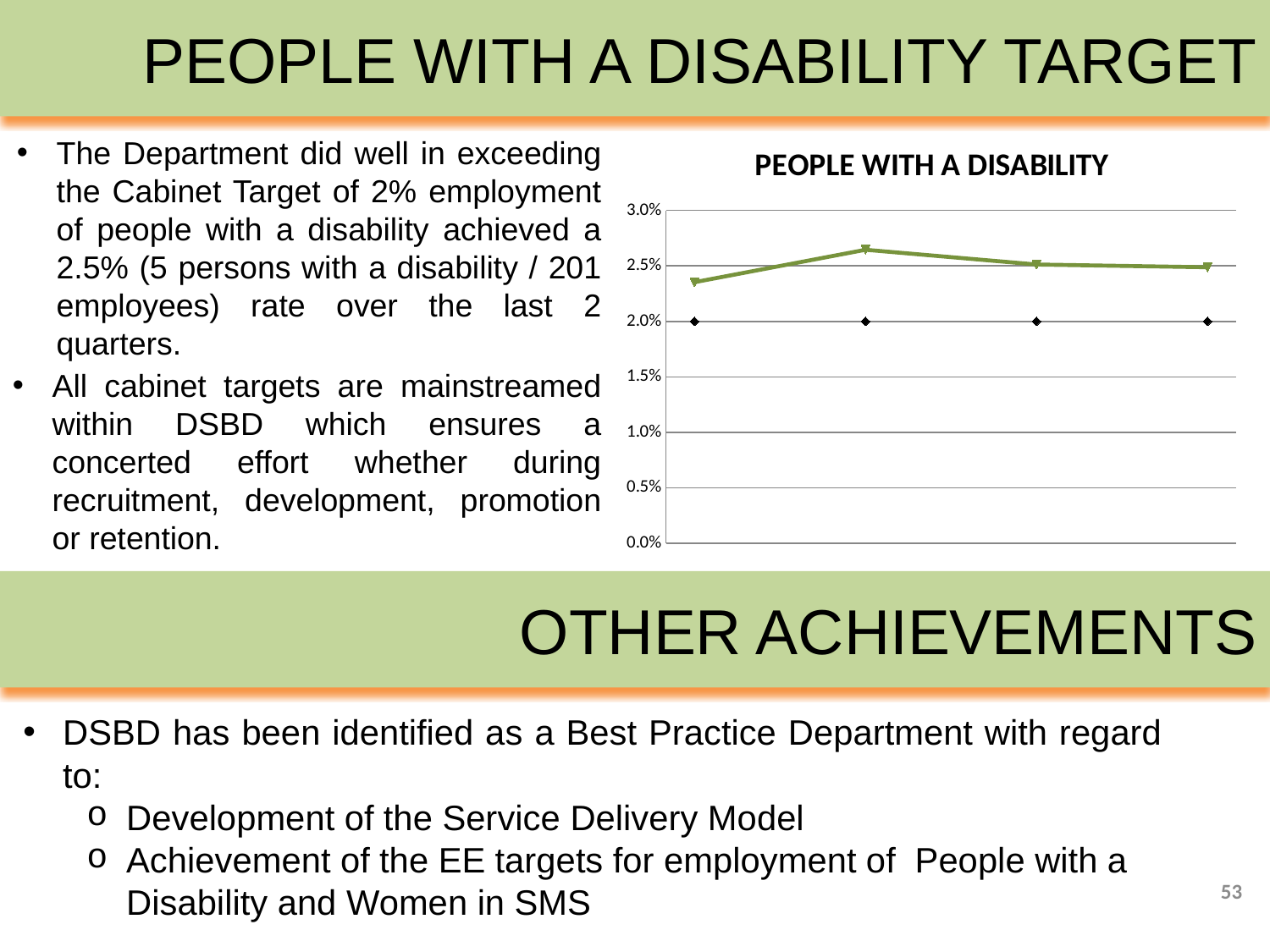
What is the title of the chart? PEOPLE WITH A DISABILITY Is the second point of the green line greater or less than 2.5%? greater What kind of chart is shown on the slide? line chart Does the green line rise or fall between its first and second points? rise What value does the flat black line with diamond markers sit at? 2.0% How many lines are plotted on the chart? 2 Which point of the green line is the lowest? the first point Is the first point of the green line greater or less than 2.0%? greater How many data points does the green line with triangle markers have? 4 Which point of the green line is the highest? the second point Which is higher at the second point: the green line or the black line? the green line Is the first point of the green line greater or less than 2.5%? less